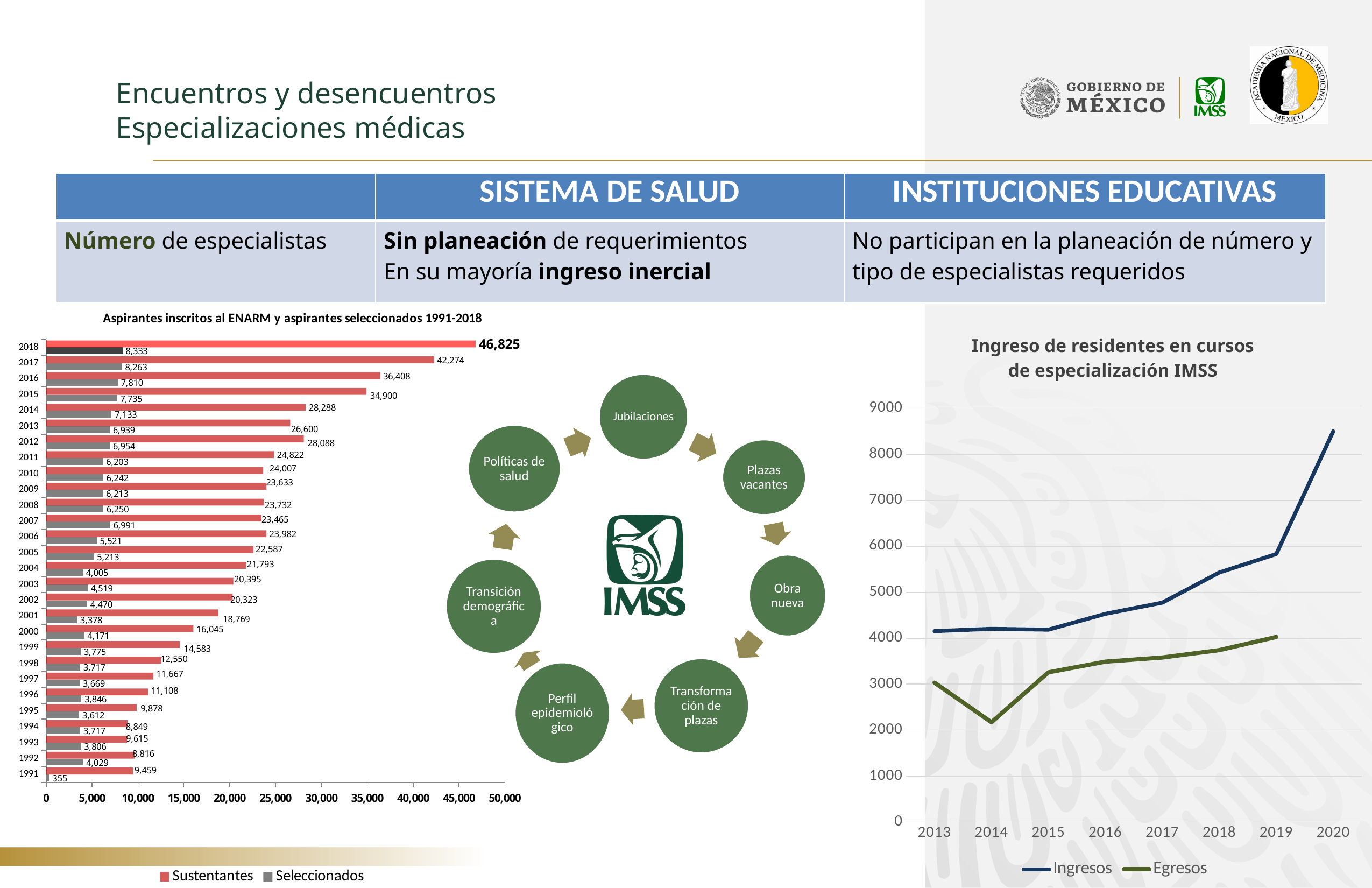
In the chart 'Aspirantes inscritos al ENARM y aspirantes seleccionados 1991-2018', which is larger: the Sustentantes value for 2014 or for 2013? 2014 In the chart 'Aspirantes inscritos al ENARM y aspirantes seleccionados 1991-2018', what is the Seleccionados value for 2017? 8,263 In the chart 'Aspirantes inscritos al ENARM y aspirantes seleccionados 1991-2018', what is the Sustentantes value for 2018? 46,825 In the chart 'Ingreso de residentes en cursos de especialización IMSS', is the Egresos value for 2014 greater or less than 3000? less What kind of chart is 'Ingreso de residentes en cursos de especialización IMSS'? Line chart In the chart 'Aspirantes inscritos al ENARM y aspirantes seleccionados 1991-2018', how many series does the legend list? 2 In the chart 'Ingreso de residentes en cursos de especialización IMSS', is the Ingresos value for 2020 greater or less than 8000? greater In the chart 'Aspirantes inscritos al ENARM y aspirantes seleccionados 1991-2018', which year has the highest Sustentantes value? 2018 In the chart 'Ingreso de residentes en cursos de especialización IMSS', which series does the legend list besides Ingresos? Egresos What kind of chart is 'Aspirantes inscritos al ENARM y aspirantes seleccionados 1991-2018'? Bar chart In the chart 'Aspirantes inscritos al ENARM y aspirantes seleccionados 1991-2018', what is the Seleccionados value for 1991? 355 In the chart 'Aspirantes inscritos al ENARM y aspirantes seleccionados 1991-2018', what is the difference between the Sustentantes values for 2018 and 2017? 4,551